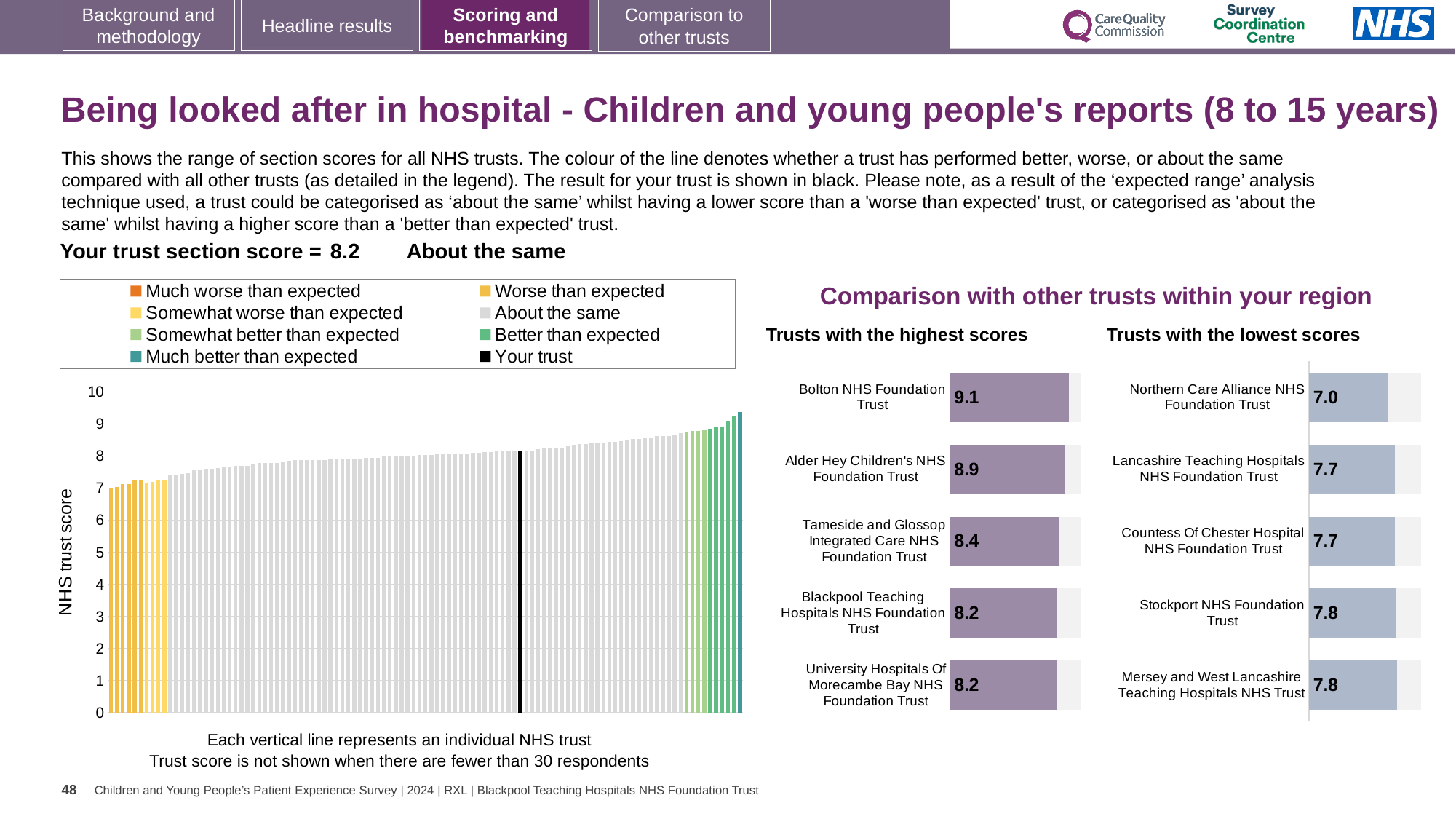
In the 'Trusts with the highest scores' chart, what is the difference between the scores of Bolton NHS Foundation Trust and Alder Hey Children's NHS Foundation Trust? 0.2 In the 'Trusts with the lowest scores' chart, which trust has the lowest score? Northern Care Alliance NHS Foundation Trust What kind of chart is the large 'NHS trust score' chart on the left of the slide? Bar chart In the 'Trusts with the highest scores' chart, what is the score for Bolton NHS Foundation Trust? 9.1 In the 'Trusts with the lowest scores' chart, what is the score for Stockport NHS Foundation Trust? 7.8 In the 'Trusts with the lowest scores' chart, which has the higher score: Lancashire Teaching Hospitals NHS Foundation Trust or Mersey and West Lancashire Teaching Hospitals NHS Trust? Mersey and West Lancashire Teaching Hospitals NHS Trust In the 'Trusts with the lowest scores' chart, what is the difference between the scores of Stockport NHS Foundation Trust and Northern Care Alliance NHS Foundation Trust? 0.8 In the 'Trusts with the highest scores' chart, what is the score for Tameside and Glossop Integrated Care NHS Foundation Trust? 8.4 How many entries does the legend above the 'NHS trust score' chart list? 8 How many trusts are shown in the 'Trusts with the highest scores' chart? 5 In the 'Trusts with the highest scores' chart, which trust has the highest score? Bolton NHS Foundation Trust In the 'Trusts with the lowest scores' chart, what is the score for Northern Care Alliance NHS Foundation Trust? 7.0